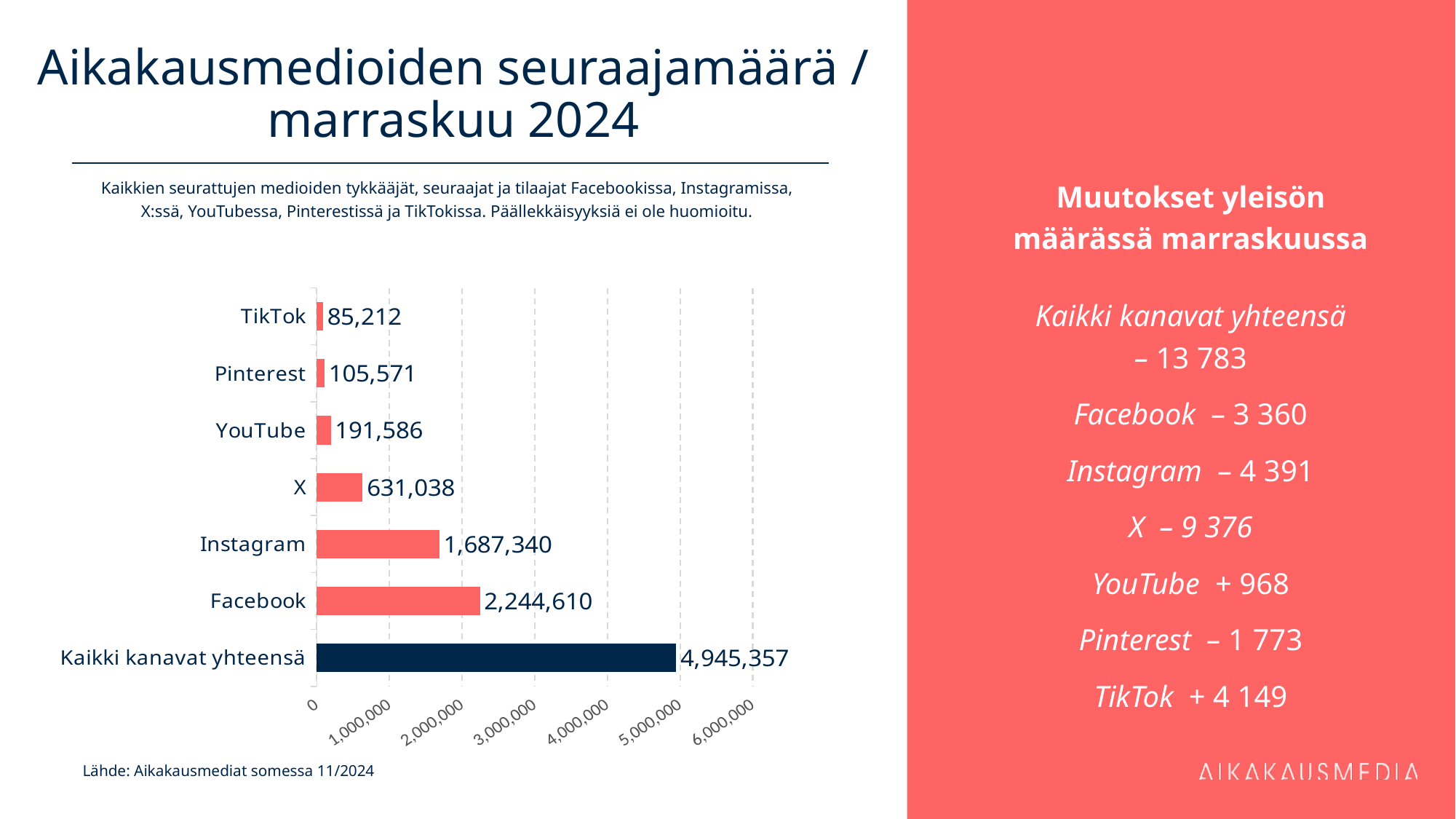
Which is larger, the value for X or the value for YouTube? X What is the value for Kaikki kanavat yhteensä? 4,945,357 Is the value for Instagram greater or less than 2,000,000? less Which category has the highest value? Kaikki kanavat yhteensä What is the value for TikTok? 85,212 What is the difference between the values for Facebook and Instagram? 557,270 What is the value for X? 631,038 What kind of chart is shown on the slide? bar chart How many categories are shown in the chart? 7 What is the difference between the values for Pinterest and TikTok? 20,359 What is the value for Facebook? 2,244,610 Which category has the lowest value? TikTok